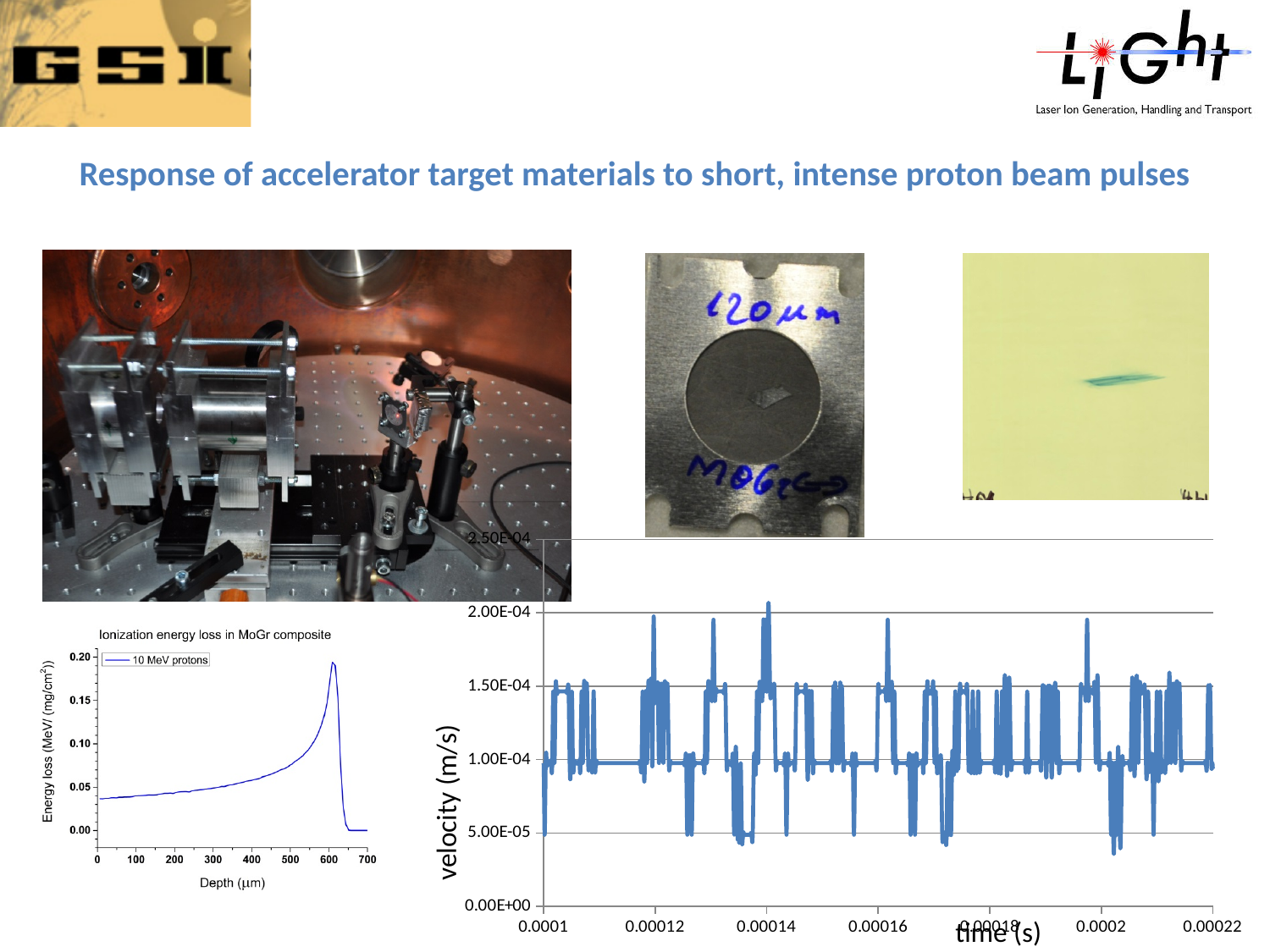
In the velocity versus time chart on the bottom right, is the highest velocity reached greater or less than 2.50E-04? less What is the x-axis label of the 'Ionization energy loss in MoGr composite' chart? Depth (μm) What is the y-axis label of the velocity versus time chart on the bottom right? velocity (m/s) In the velocity versus time chart on the bottom right, is the lowest velocity reached (near time 0.0002) greater or less than 5.00E-05? less In the 'Ionization energy loss in MoGr composite' chart, does the energy loss rise or fall between depths of 100 μm and 600 μm? rise In the 'Ionization energy loss in MoGr composite' chart, is the peak energy loss greater or less than 0.15? greater How many tick labels are shown on the x axis of the velocity versus time chart on the bottom right? 7 What kind of chart is the 'Ionization energy loss in MoGr composite' chart? line chart What kind of chart is the velocity versus time chart on the bottom right of the slide? line chart In the 'Ionization energy loss in MoGr composite' chart, what is the legend entry for the plotted series? 10 MeV protons How many series does the legend of the 'Ionization energy loss in MoGr composite' chart list? 1